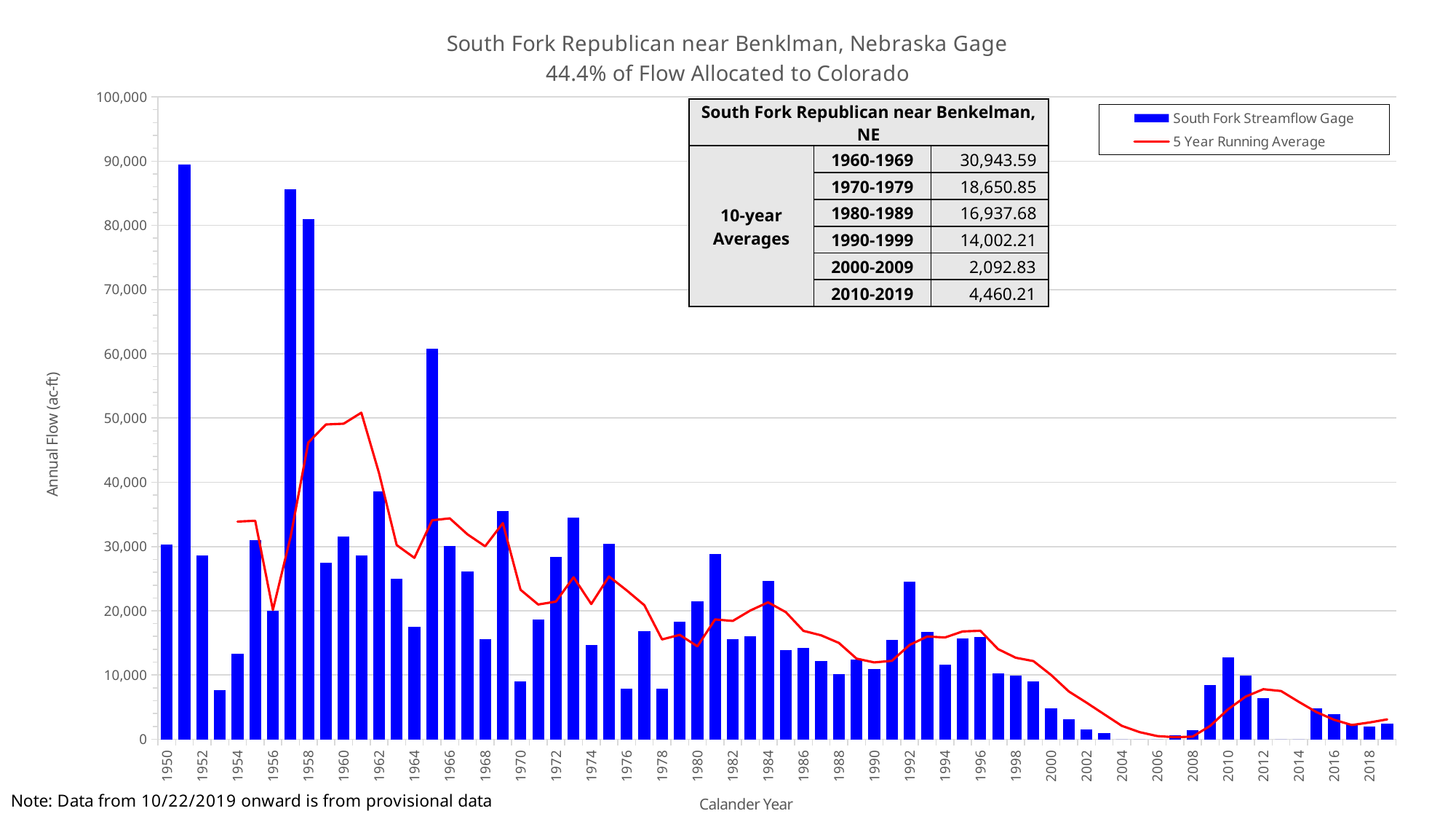
What is the difference between the 1960-1969 and 1970-1979 10-year averages in the table? 12,292.74 Which year has the highest annual flow bar on the chart? 1951 Is the annual flow bar for 1951 greater or less than 80,000? greater According to the 10-year averages table, what is the average for 1960-1969? 30,943.59 Is the annual flow bar for 1965 greater or less than 50,000? greater According to the 10-year averages table, which decade has the lowest average? 2000-2009 Is the annual flow bar for 1957 greater or less than 80,000? greater How many series does the chart legend list? 2 What is the label of the vertical axis? Annual Flow (ac-ft) Overall, do the annual flow values rise or fall from 1950 to 2019? fall What kind of chart is used to show the South Fork Streamflow Gage data? bar chart